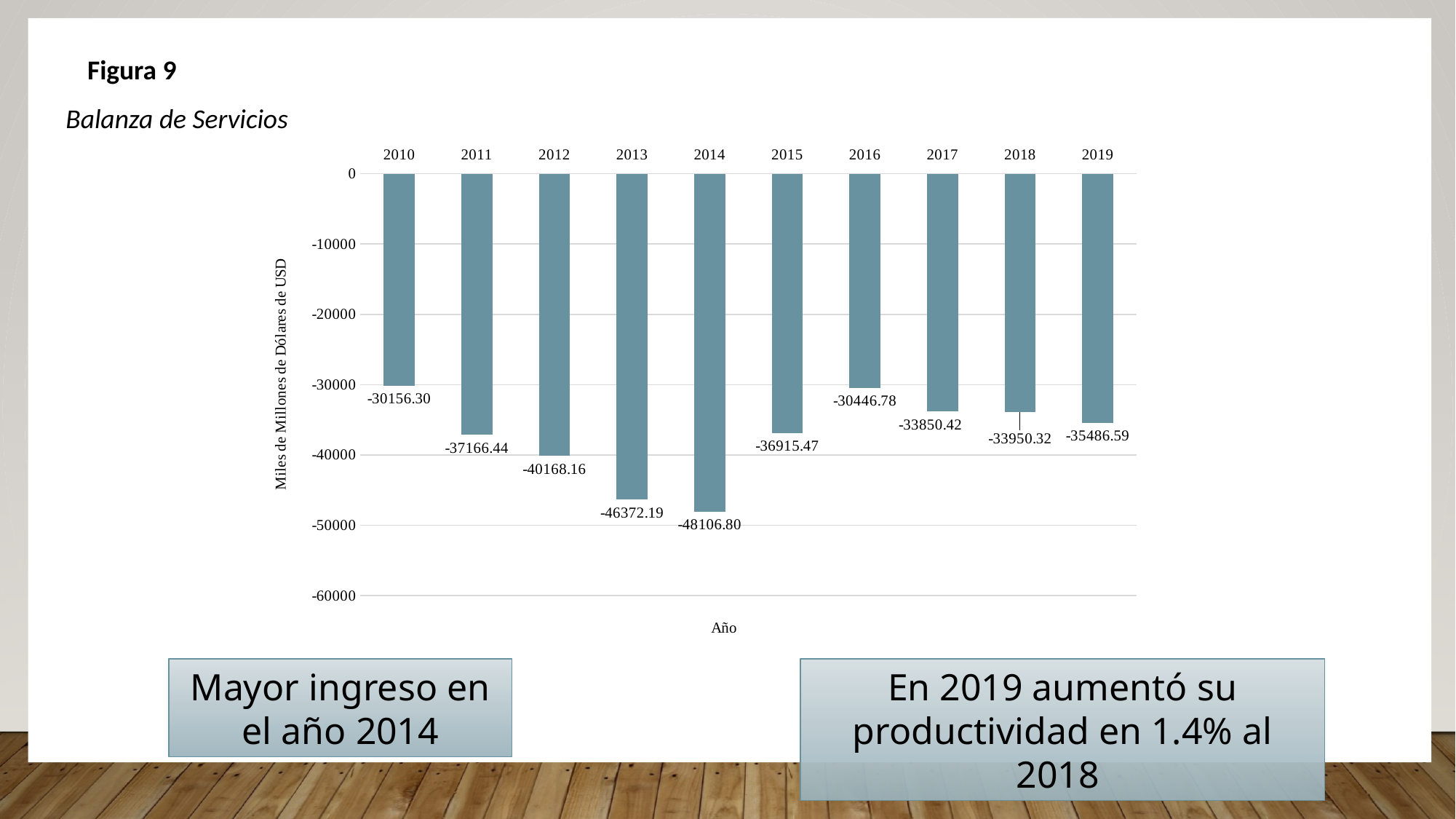
What is the value for 2010 in the Balanza de Servicios chart? -30156.30 Which year has the larger (less negative) value, 2012 or 2015? 2015 Is the value for 2013 greater or less than -40000? less What is the value for 2019 in the Balanza de Servicios chart? -35486.59 Which year has the highest (least negative) value in the Balanza de Servicios chart? 2010 How many years are shown in the Balanza de Servicios chart? 10 What kind of chart is shown on the slide? Bar chart What is the value for 2014 in the Balanza de Servicios chart? -48106.80 What is the value for 2016 in the Balanza de Servicios chart? -30446.78 What is the difference between the values for 2014 and 2013 in the Balanza de Servicios chart? 1734.61 Which year has the lowest (most negative) value in the Balanza de Servicios chart? 2014 What is the difference between the values for 2019 and 2018 in the Balanza de Servicios chart? 1536.27